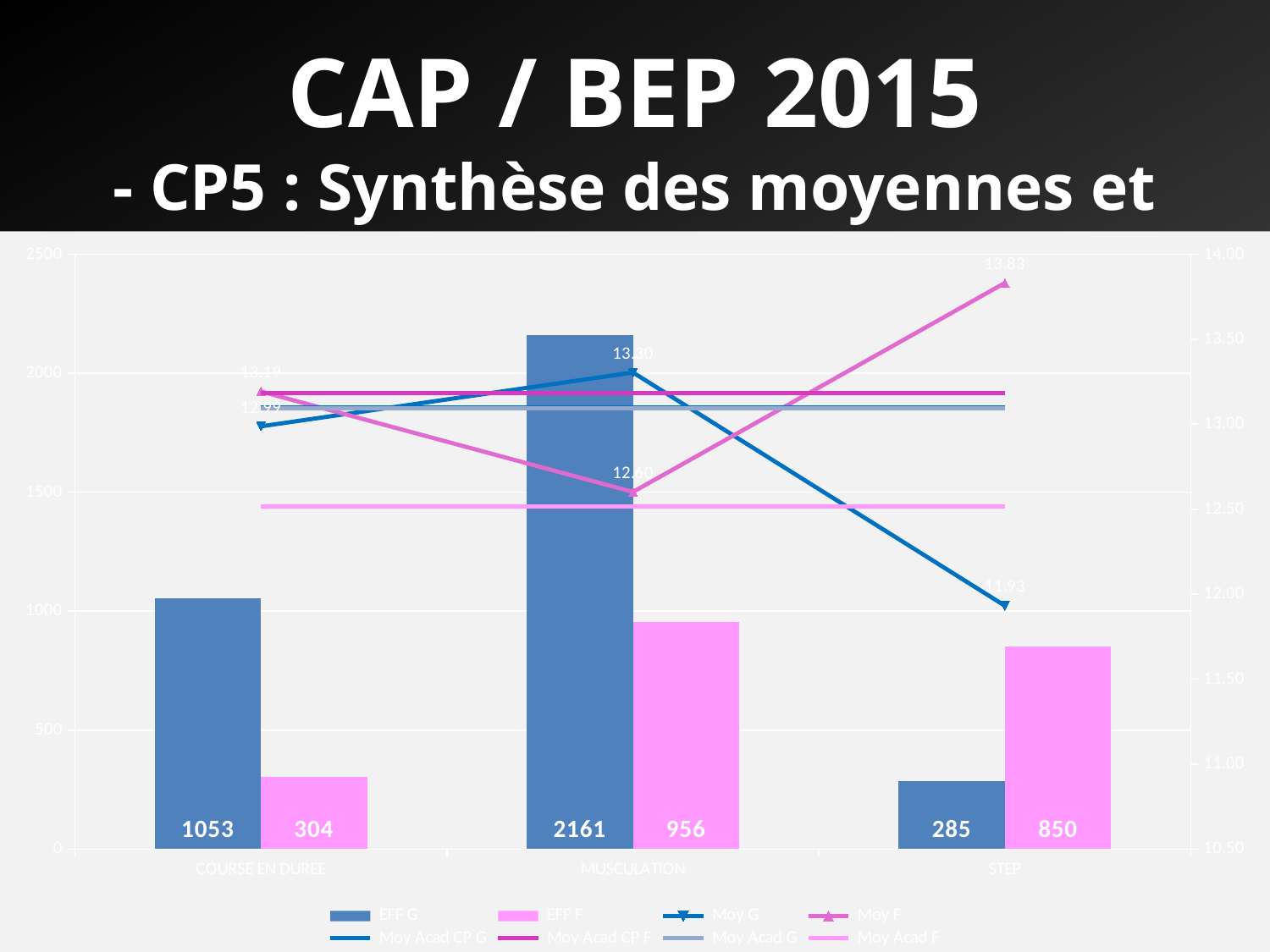
What is the value of EFF F for COURSE EN DUREE? 304 How many categories are shown on the x axis? 3 Which category has the lowest EFF F value? COURSE EN DUREE For STEP, which is larger, EFF G or EFF F? EFF F What is the Moy G value for STEP? 11.93 What is the value of EFF F for STEP? 850 What is the value of EFF G for MUSCULATION? 2161 How many series does the legend list? 8 What is the Moy F value for STEP? 13.83 Does the Moy G line rise or fall from MUSCULATION to STEP? fall Which category has the highest EFF G value? MUSCULATION What is the difference between EFF G and EFF F for COURSE EN DUREE? 749